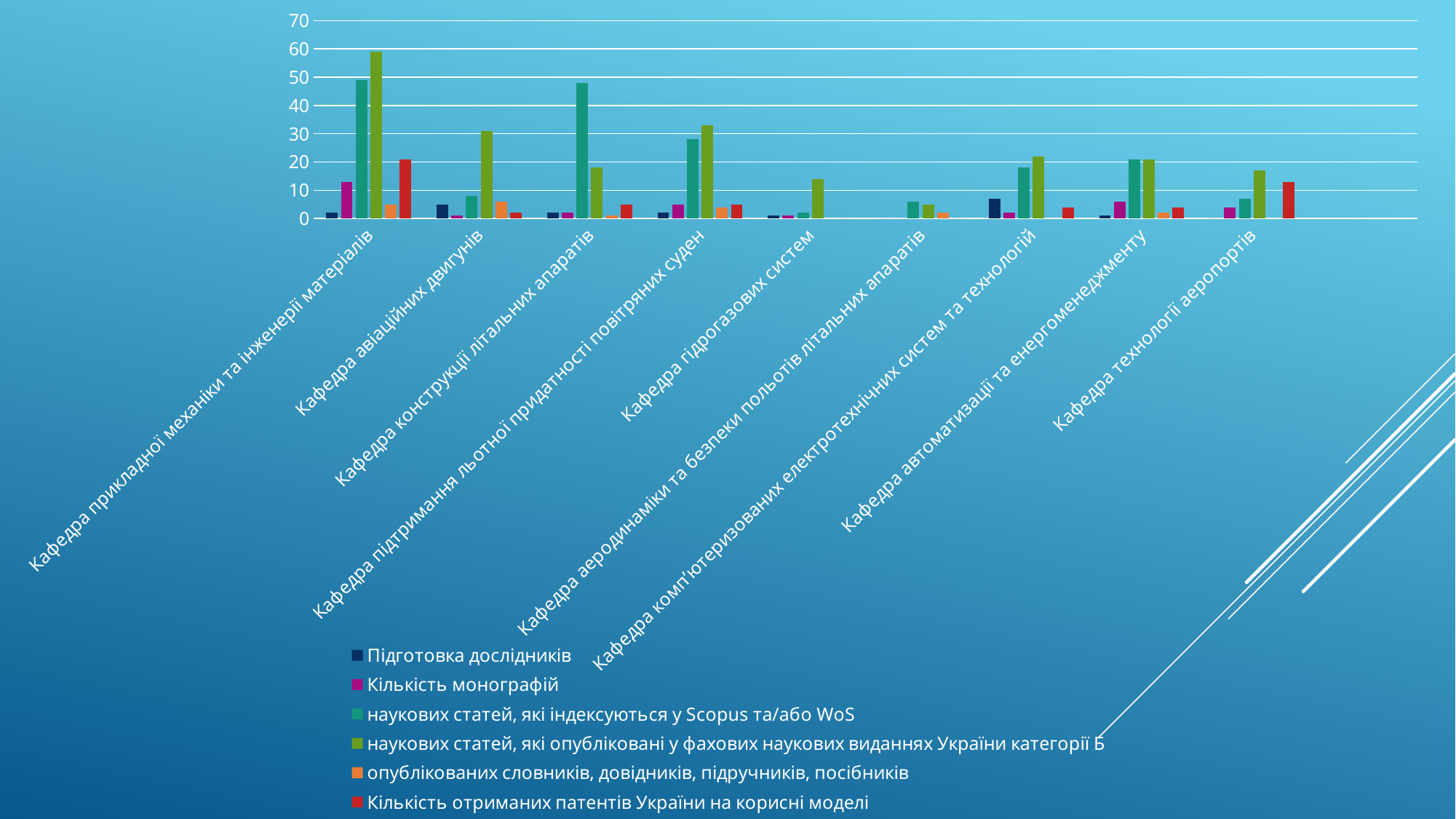
Which is larger at Кафедра конструкції літальних апаратів: the value for 'наукових статей, які індексуються у Scopus та/або WoS' or the value for 'наукових статей, які опубліковані у фахових наукових виданнях України категорії Б'? наукових статей, які індексуються у Scopus та/або WoS Is the value for 'наукових статей, які опубліковані у фахових наукових виданнях України категорії Б' at Кафедра гідрогазових систем greater or less than 20? less Which is larger at Кафедра технології аеропортів: the value for 'Кількість отриманих патентів України на корисні моделі' or the value for 'наукових статей, які індексуються у Scopus та/або WoS'? Кількість отриманих патентів України на корисні моделі How many series does the legend list? 6 What kind of chart is shown on the slide? bar chart How many departments (categories) are shown along the x axis? 9 Which department has the highest value for 'Кількість отриманих патентів України на корисні моделі'? Кафедра прикладної механіки та інженерії матеріалів Which department has the highest value for 'наукових статей, які опубліковані у фахових наукових виданнях України категорії Б'? Кафедра прикладної механіки та інженерії матеріалів What colour represents the series 'Кількість отриманих патентів України на корисні моделі' in the legend? red Is the value for 'наукових статей, які опубліковані у фахових наукових виданнях України категорії Б' at Кафедра авіаційних двигунів greater or less than 20? greater Is the value for 'наукових статей, які індексуються у Scopus та/або WoS' at Кафедра конструкції літальних апаратів greater or less than 40? greater